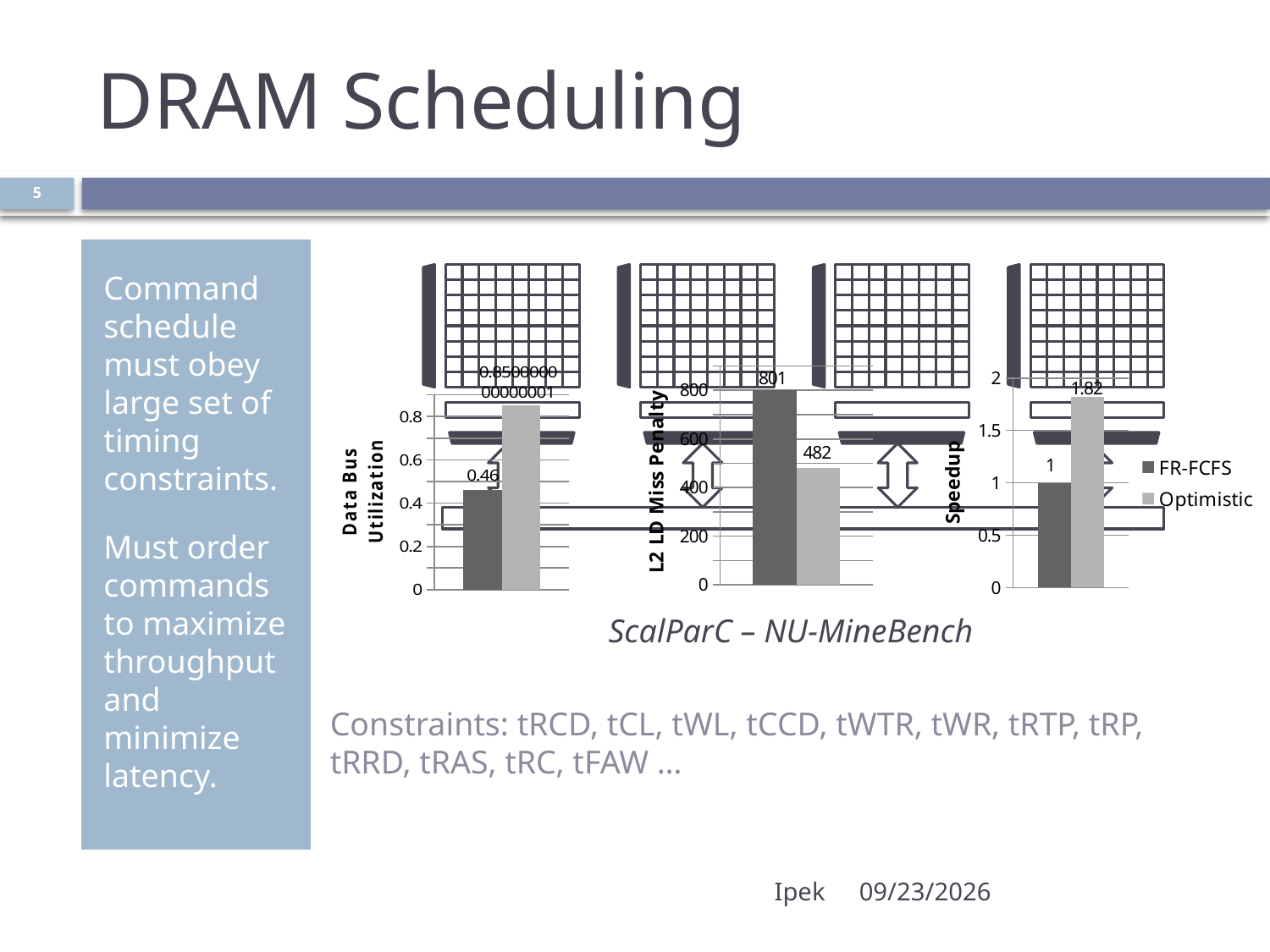
In the Speedup chart, what is the difference between the Optimistic and FR-FCFS values? 0.82 In the Speedup chart, what is the value for Optimistic? 1.82 What kind of chart is the Speedup chart? bar chart In the L2 LD Miss Penalty chart, what is the value for Optimistic? 482 In the Speedup chart, what is the value for FR-FCFS? 1 In the Data Bus Utilization chart, is the value for Optimistic greater or less than 0.8? greater In the L2 LD Miss Penalty chart, which series has the lower value? Optimistic In the Data Bus Utilization chart, which series has the higher value, FR-FCFS or Optimistic? Optimistic In the L2 LD Miss Penalty chart, what is the value for FR-FCFS? 801 In the Data Bus Utilization chart, what is the value for FR-FCFS? 0.46 How many series does the legend list? 2 In the L2 LD Miss Penalty chart, what is the difference between the FR-FCFS and Optimistic values? 319